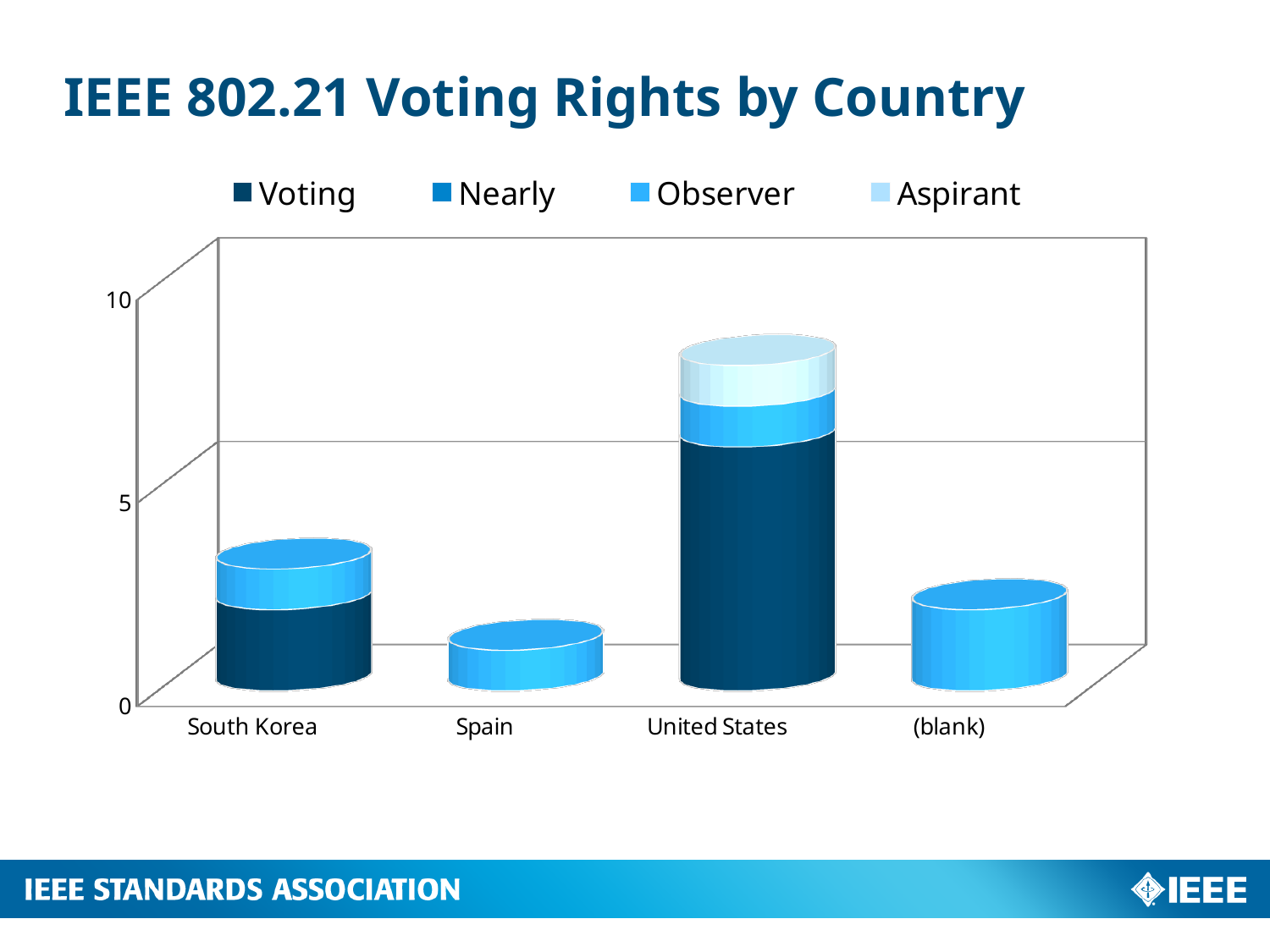
How many series does the legend list? 4 Which has the taller stacked bar, South Korea or (blank)? South Korea Is the total for United States greater or less than 5? greater Which category is the only one with an Aspirant segment? United States What kind of chart is shown on the slide? bar chart Which category has the tallest stacked bar? United States Which has the taller stacked bar, Spain or (blank)? (blank) How many categories are shown on the x axis? 4 What is the title of the chart? IEEE 802.21 Voting Rights by Country Which category has the shortest stacked bar? Spain Is the total for South Korea greater or less than 5? less Is the total for Spain greater or less than 5? less